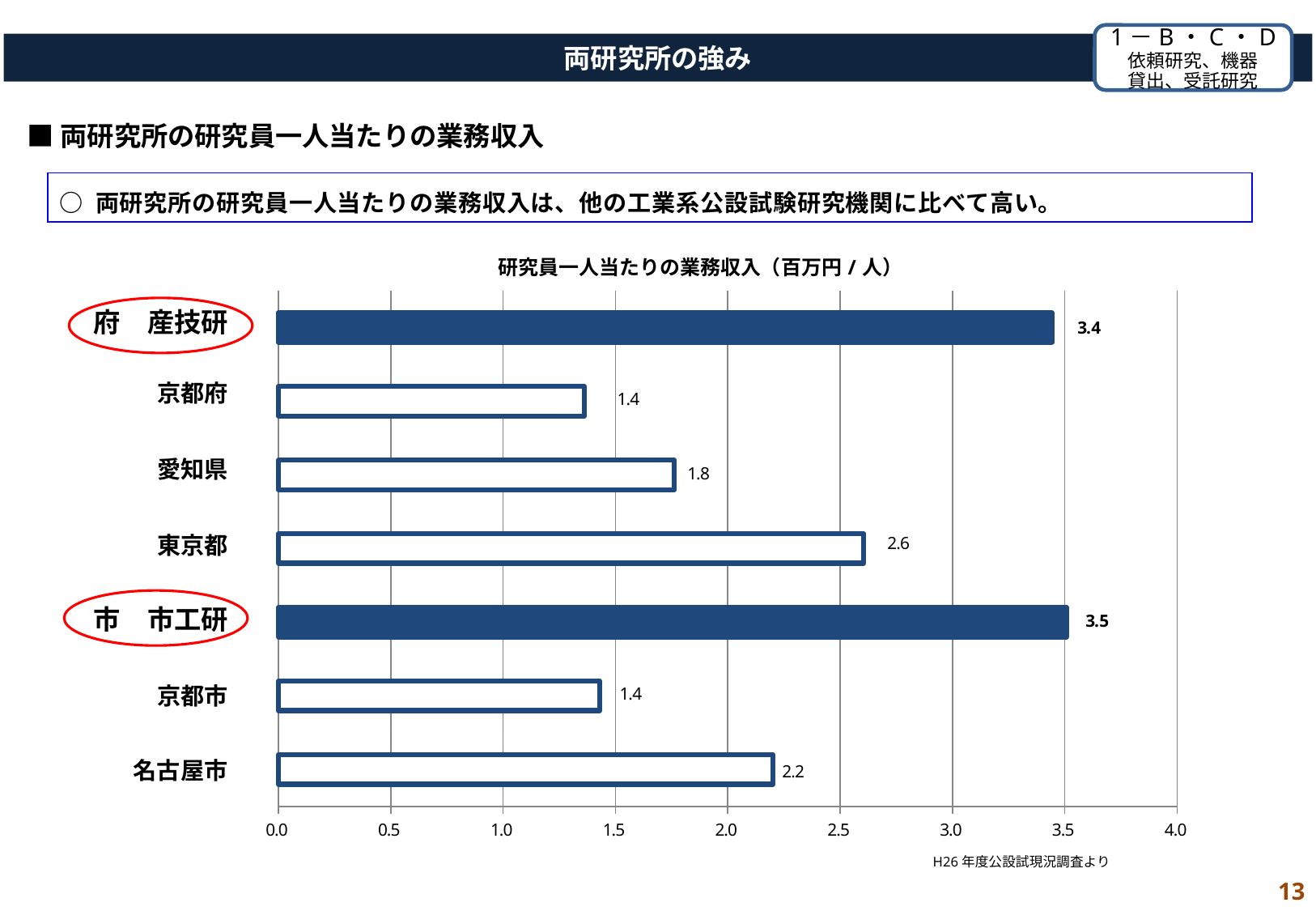
Which category has the highest value in the chart? 市 市工研 What is the title of the chart? 研究員一人当たりの業務収入（百万円 / 人） Which is larger, the value for 名古屋市 or the value for 愛知県? 名古屋市 What is the difference between the values for 市 市工研 and 府 産技研? 0.1 How many categories are shown in the chart? 7 Is the value for 東京都 greater or less than 2.0? greater What is the value for 名古屋市 in the chart? 2.2 What is the value for 府 産技研 in the chart? 3.4 What kind of chart is shown on the slide? Bar chart What is the difference between the values for 東京都 and 京都府? 1.2 What is the value for 愛知県 in the chart? 1.8 What is the value for 東京都 in the chart? 2.6